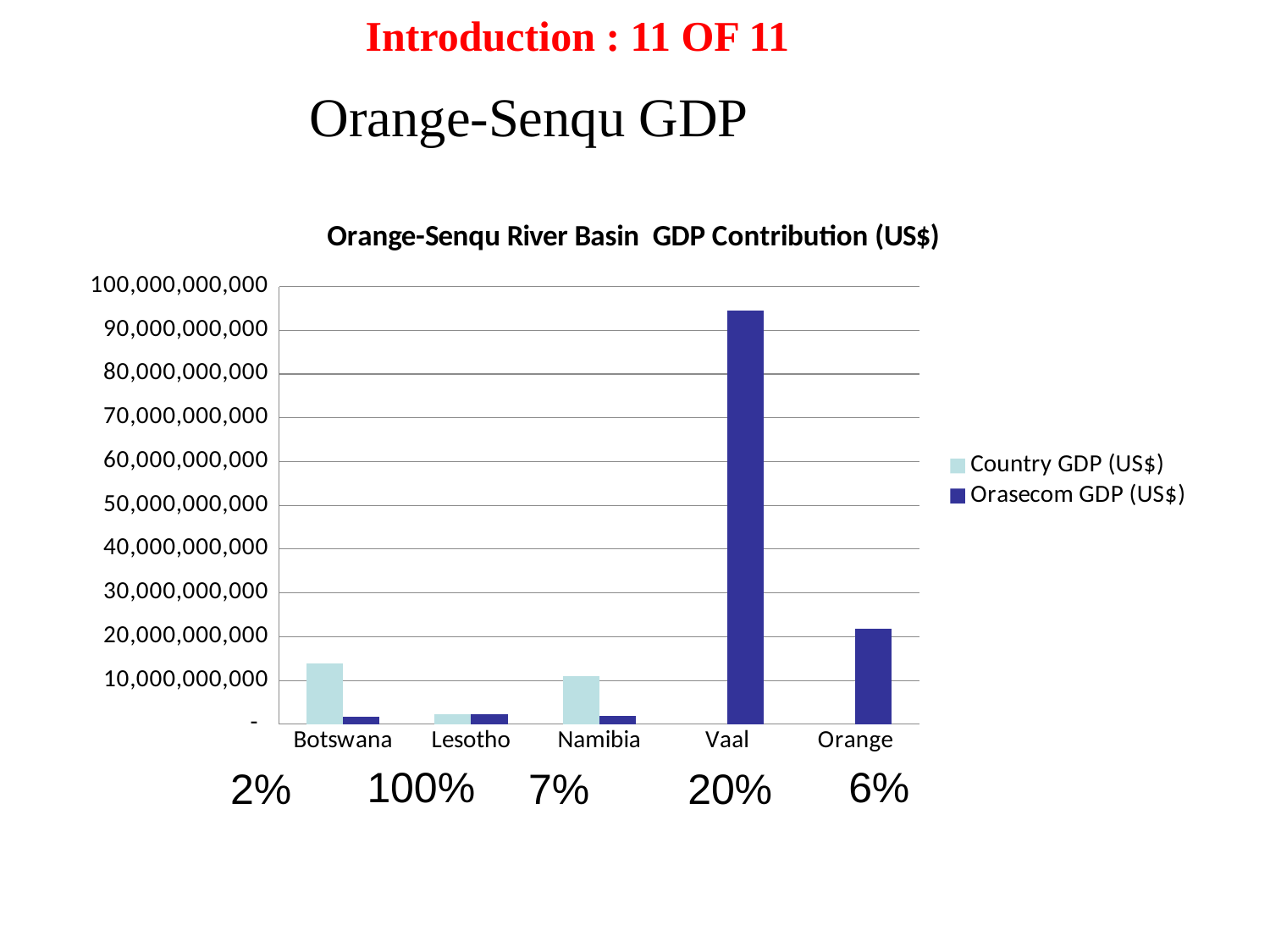
Is the Orasecom GDP (US$) value for Vaal greater or less than 90,000,000,000? greater Is the Country GDP (US$) value for Lesotho greater or less than 10,000,000,000? less Is the Orasecom GDP (US$) value for Orange greater or less than 30,000,000,000? less How many categories are shown on the x axis of the chart? 5 What kind of chart is shown on the slide? bar chart Which category has the highest Country GDP (US$) bar? Botswana Which is larger for Namibia, Country GDP (US$) or Orasecom GDP (US$)? Country GDP (US$) How many series does the chart legend list? 2 What is the title of the chart? Orange-Senqu River Basin GDP Contribution (US$) Which category has the highest Orasecom GDP (US$) bar? Vaal Which is larger, the Orasecom GDP (US$) for Vaal or the Orasecom GDP (US$) for Orange? Vaal